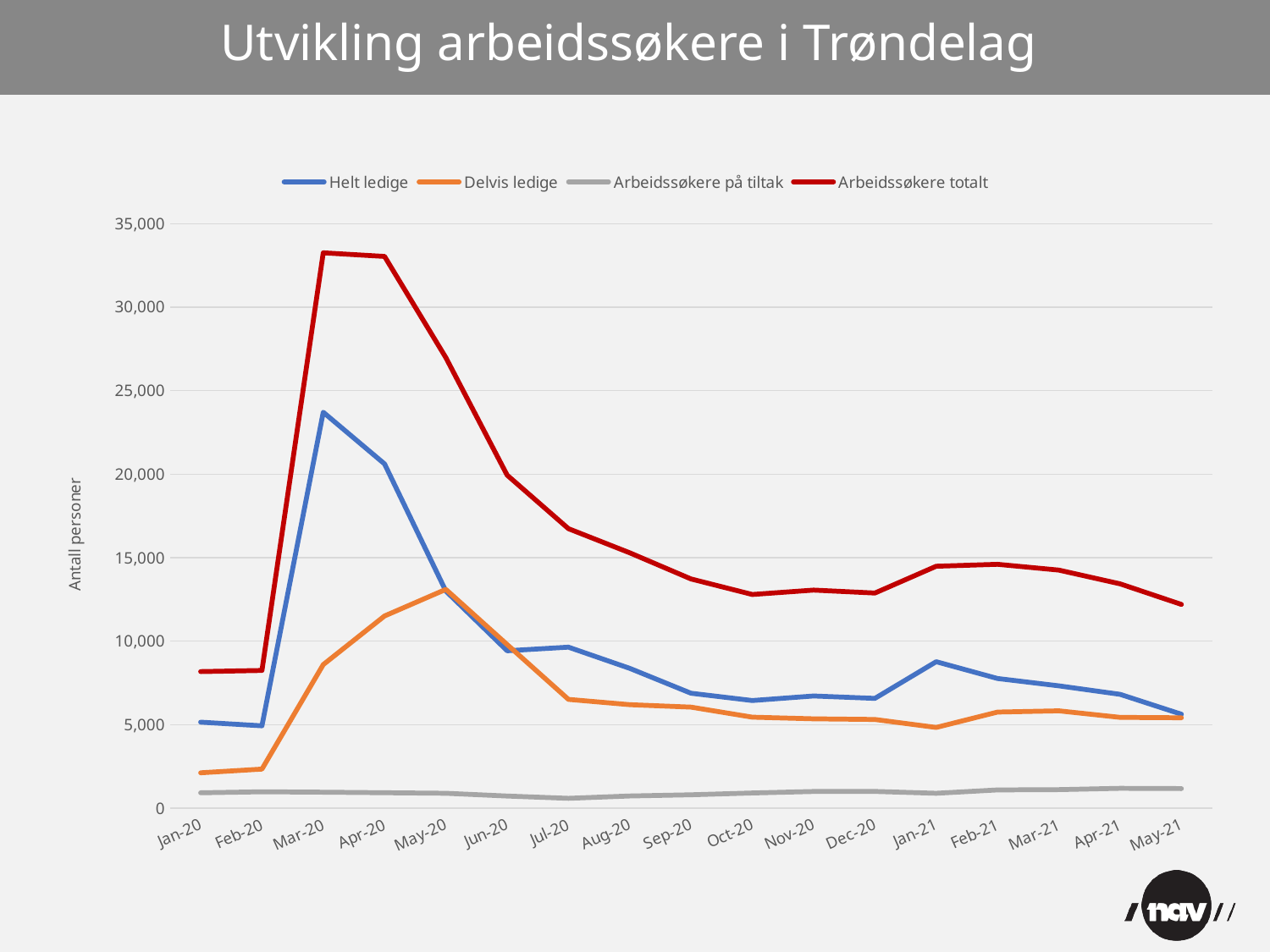
Is the value for Helt ledige in Jan-20 greater or less than 10,000? less What is the label on the y axis? Antall personer What kind of chart is shown on the slide? Line chart Is the value for Arbeidssøkere totalt in Mar-20 greater or less than 30,000? greater How many months are plotted along the x axis? 17 What is the title of the chart? Utvikling arbeidssøkere i Trøndelag Does the Arbeidssøkere totalt series rise or fall from Apr-20 to Oct-20? Fall Is the value for Arbeidssøkere på tiltak in Jan-21 greater or less than 5,000? less In Apr-20, which is larger: Helt ledige or Delvis ledige? Helt ledige How many series does the legend list? 4 In which month does the Helt ledige series reach its highest value? Mar-20